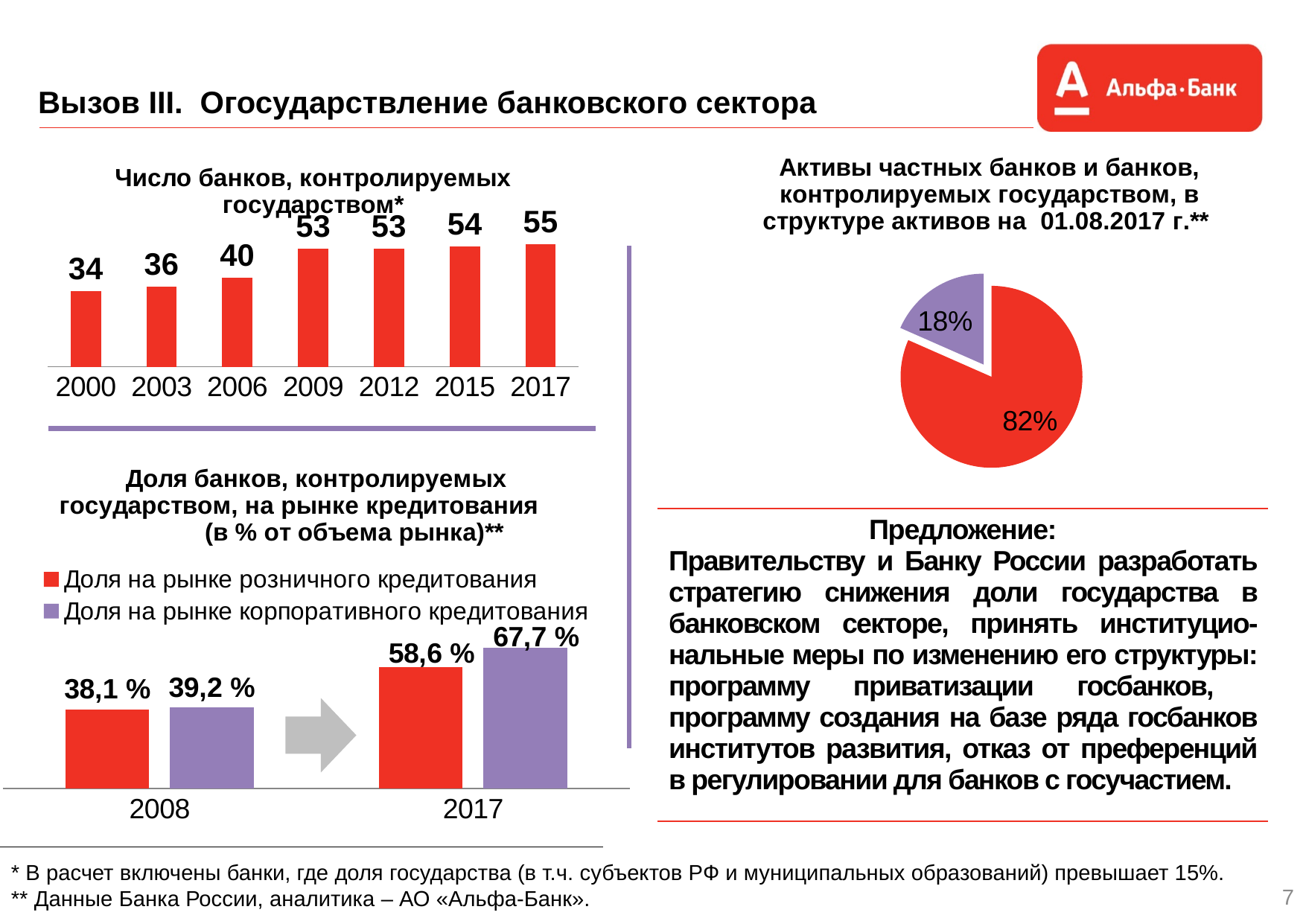
In the chart 'Доля банков, контролируемых государством, на рынке кредитования', what is the value of 'Доля на рынке корпоративного кредитования' for 2017? 67,7 % In the chart 'Число банков, контролируемых государством*', what is the value for 2009? 53 How many years are shown on the x axis of the chart 'Число банков, контролируемых государством*'? 7 In the chart 'Доля банков, контролируемых государством, на рынке кредитования', what is the value of 'Доля на рынке розничного кредитования' for 2008? 38,1 % How many series does the legend of the chart 'Доля банков, контролируемых государством, на рынке кредитования' list? 2 What kind of chart is the chart on the right side of the slide, 'Активы частных банков и банков, контролируемых государством...'? pie chart In the chart 'Число банков, контролируемых государством*', which year has the highest value? 2017 In the pie chart 'Активы частных банков и банков, контролируемых государством, в структуре активов на 01.08.2017 г.**', what share does the purple slice represent? 18% In the chart 'Число банков, контролируемых государством*', which year has the lowest value? 2000 In the chart 'Число банков, контролируемых государством*', what is the difference between the values for 2017 and 2000? 21 In the chart 'Доля банков, контролируемых государством, на рынке кредитования', which is larger for 2017: 'Доля на рынке розничного кредитования' or 'Доля на рынке корпоративного кредитования'? Доля на рынке корпоративного кредитования Do the values in the chart 'Число банков, контролируемых государством*' rise or fall from 2000 to 2017? rise